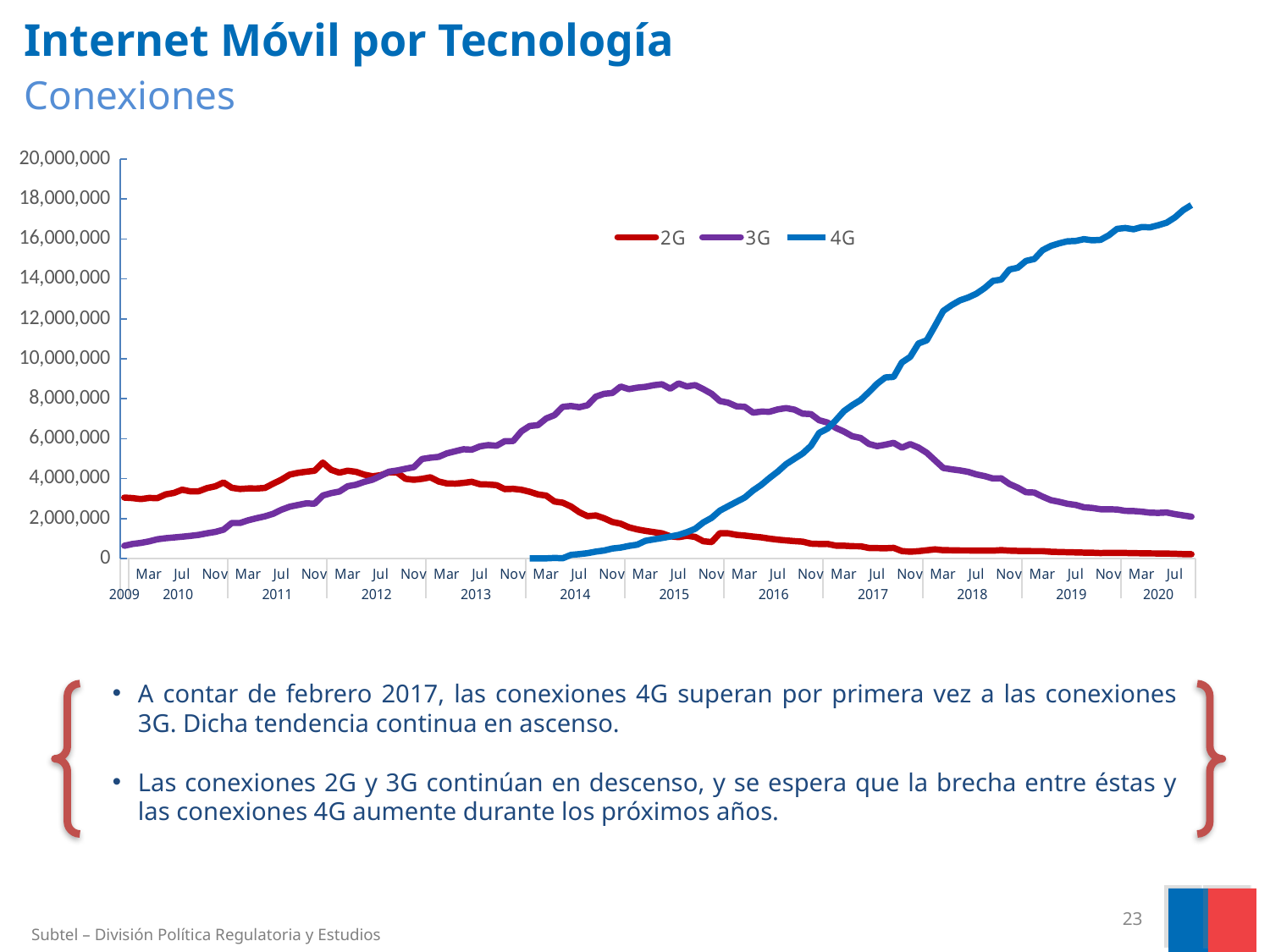
How many series does the chart legend list? 3 What kind of chart is shown on the slide? line chart Which series has the lowest value at the end of the chart (Jul 2020)? 2G Is the 4G value in Jul 2020 greater or less than 16,000,000? greater Is the peak 3G value in 2015 greater or less than 8,000,000? greater What colour is the 3G line in the chart? purple In Jul 2020, which is larger, the 3G value or the 4G value? 4G Which series has the highest value at the end of the chart (Jul 2020)? 4G Does the 4G line rise or fall from 2014 to 2020? rise Which series are listed in the chart legend? 2G, 3G, 4G Is the 2G value in Jul 2020 greater or less than 2,000,000? less Does the 2G line rise or fall from 2012 to 2020? fall